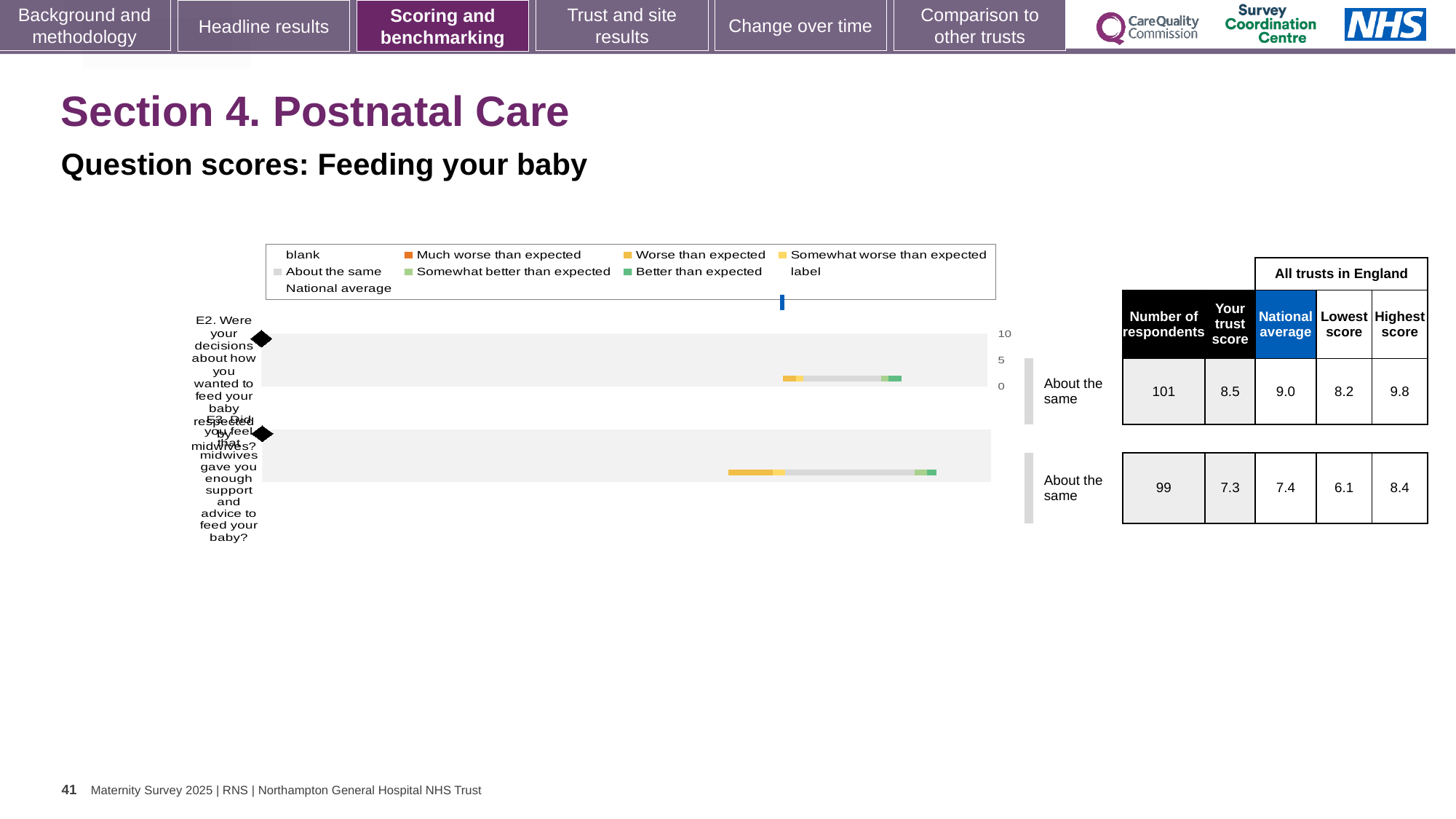
What is the lowest score among all trusts in England for question E3? 6.1 Which benchmark category is shown for both E2 and E3? About the same In the chart legend, which colour represents 'Much worse than expected'? orange What is the difference between the trust scores for E2 and E3? 1.2 How many questions (categories) are plotted in the chart? 2 What is the national average for question E3 shown in the table? 7.4 What kind of chart is shown on the slide? bar chart Which question has the higher trust score, E2 or E3? E2 What is the highest score among all trusts in England for question E2? 9.8 How many respondents answered question E2? 101 According to the table beside the chart, what is the trust score for question E2? 8.5 According to the table beside the chart, what is the trust score for question E3? 7.3